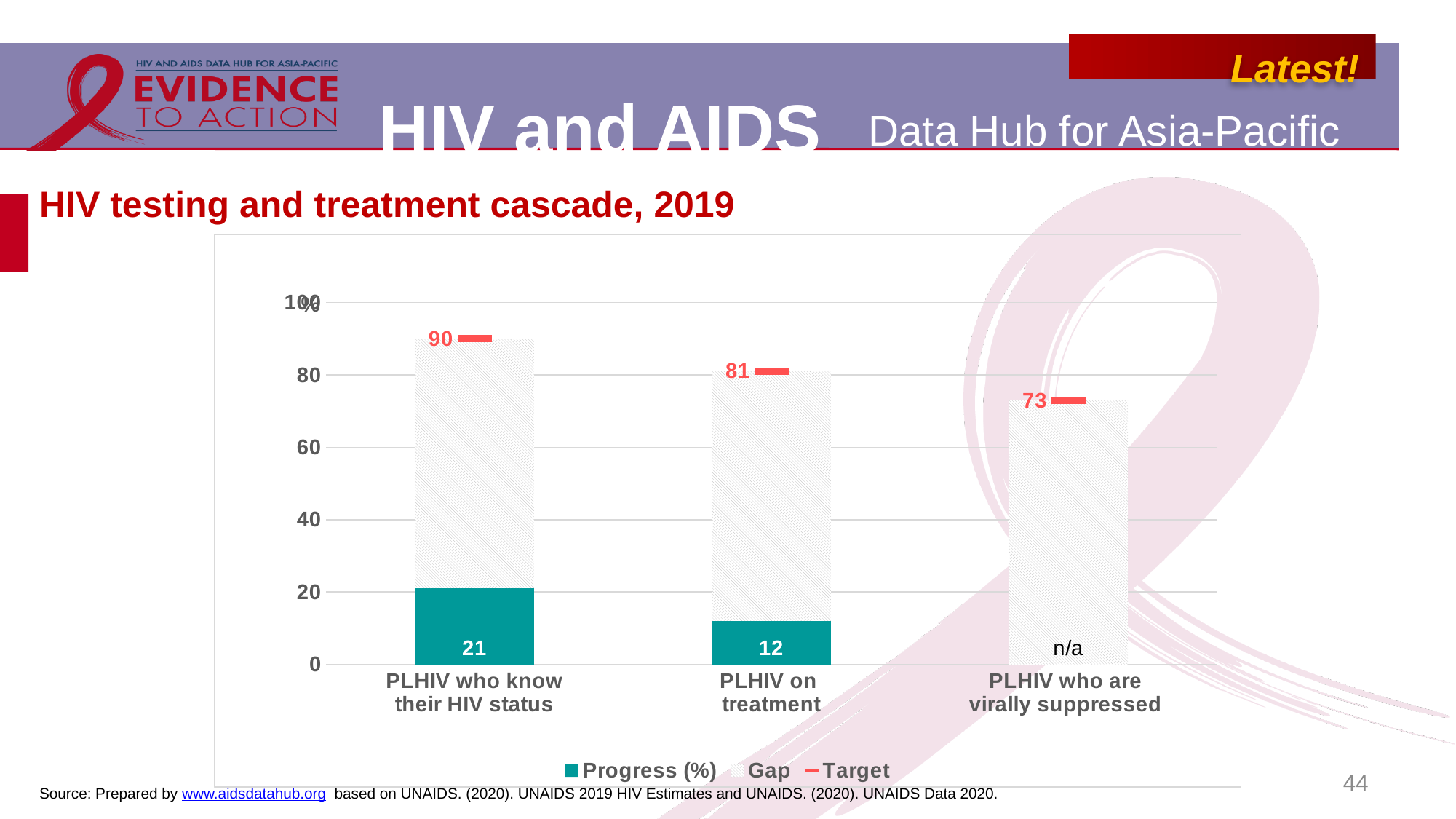
What is the Target value for PLHIV who are virally suppressed? 73 What is the difference between the Target and Progress (%) values for PLHIV who know their HIV status? 69 How many series does the legend list? 3 What is the Target value for PLHIV on treatment? 81 Which category has the highest Target value? PLHIV who know their HIV status What is the Progress (%) value for PLHIV who know their HIV status? 21 Which is larger, the Progress (%) for PLHIV who know their HIV status or for PLHIV on treatment? PLHIV who know their HIV status Which category has the lowest Target value? PLHIV who are virally suppressed What is the Progress (%) label shown for PLHIV who are virally suppressed? n/a How many categories are shown on the x axis? 3 What is the Progress (%) value for PLHIV on treatment? 12 What is the Target value for PLHIV who know their HIV status? 90